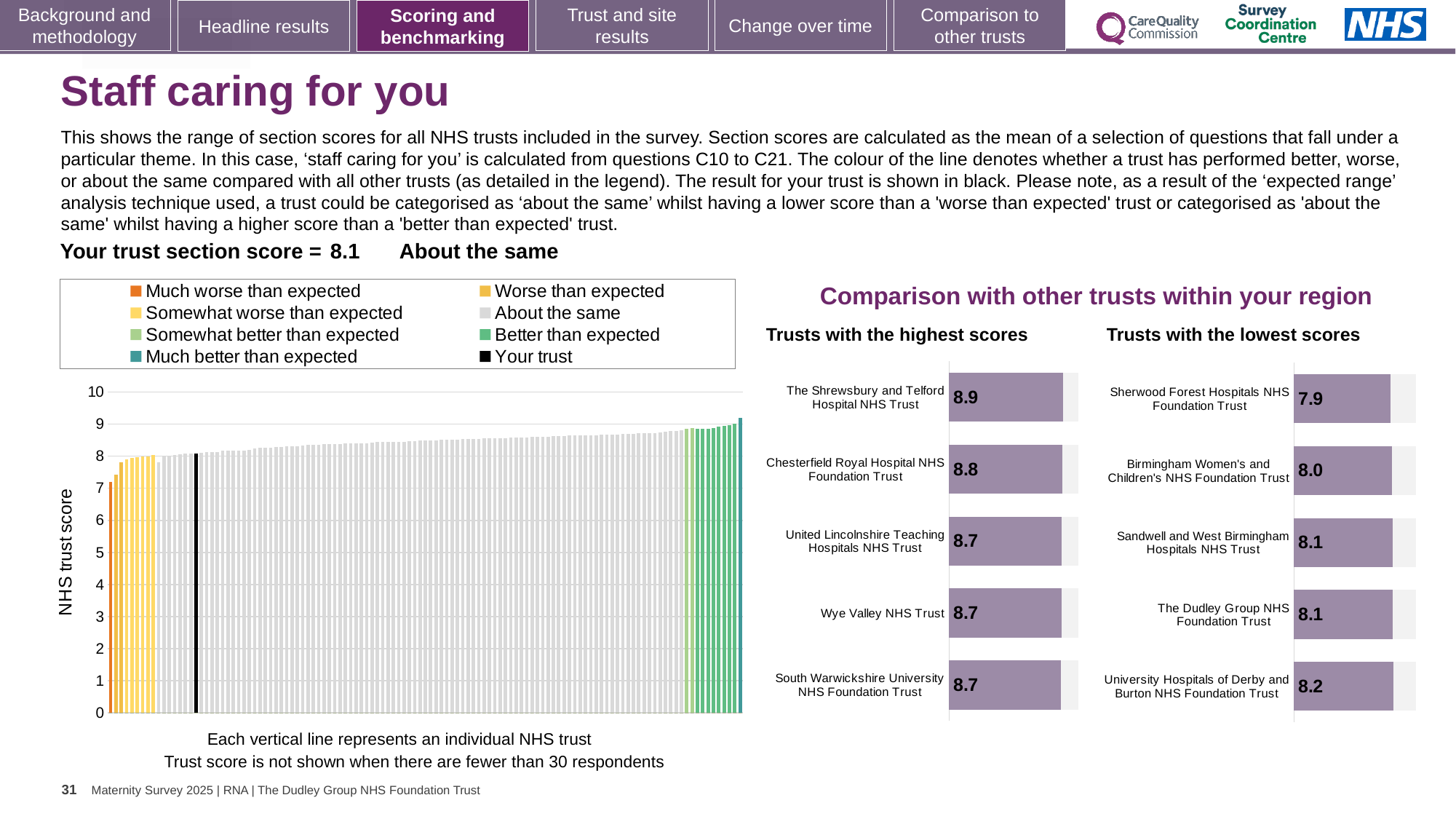
In the 'Trusts with the highest scores' chart, which trust has the highest score? The Shrewsbury and Telford Hospital NHS Trust In the large chart on the left, do the trust scores rise or fall from left to right? Rise How many trusts are shown in the 'Trusts with the highest scores' chart? 5 In the 'Trusts with the lowest scores' chart, which has the larger score: Sherwood Forest Hospitals NHS Foundation Trust or University Hospitals of Derby and Burton NHS Foundation Trust? University Hospitals of Derby and Burton NHS Foundation Trust In the 'Trusts with the highest scores' chart, what is the difference between the scores of The Shrewsbury and Telford Hospital NHS Trust and Wye Valley NHS Trust? 0.2 In the 'Trusts with the highest scores' chart, what is the score for Chesterfield Royal Hospital NHS Foundation Trust? 8.8 In the 'Trusts with the lowest scores' chart, what is the score for The Dudley Group NHS Foundation Trust? 8.1 What kind of chart is the large chart on the left showing NHS trust scores? Bar chart In the 'Trusts with the highest scores' chart, what is the score for The Shrewsbury and Telford Hospital NHS Trust? 8.9 In the 'Trusts with the lowest scores' chart, which trust has the lowest score? Sherwood Forest Hospitals NHS Foundation Trust How many entries does the legend above the large chart on the left list? 8 In the 'Trusts with the lowest scores' chart, what is the score for Sherwood Forest Hospitals NHS Foundation Trust? 7.9